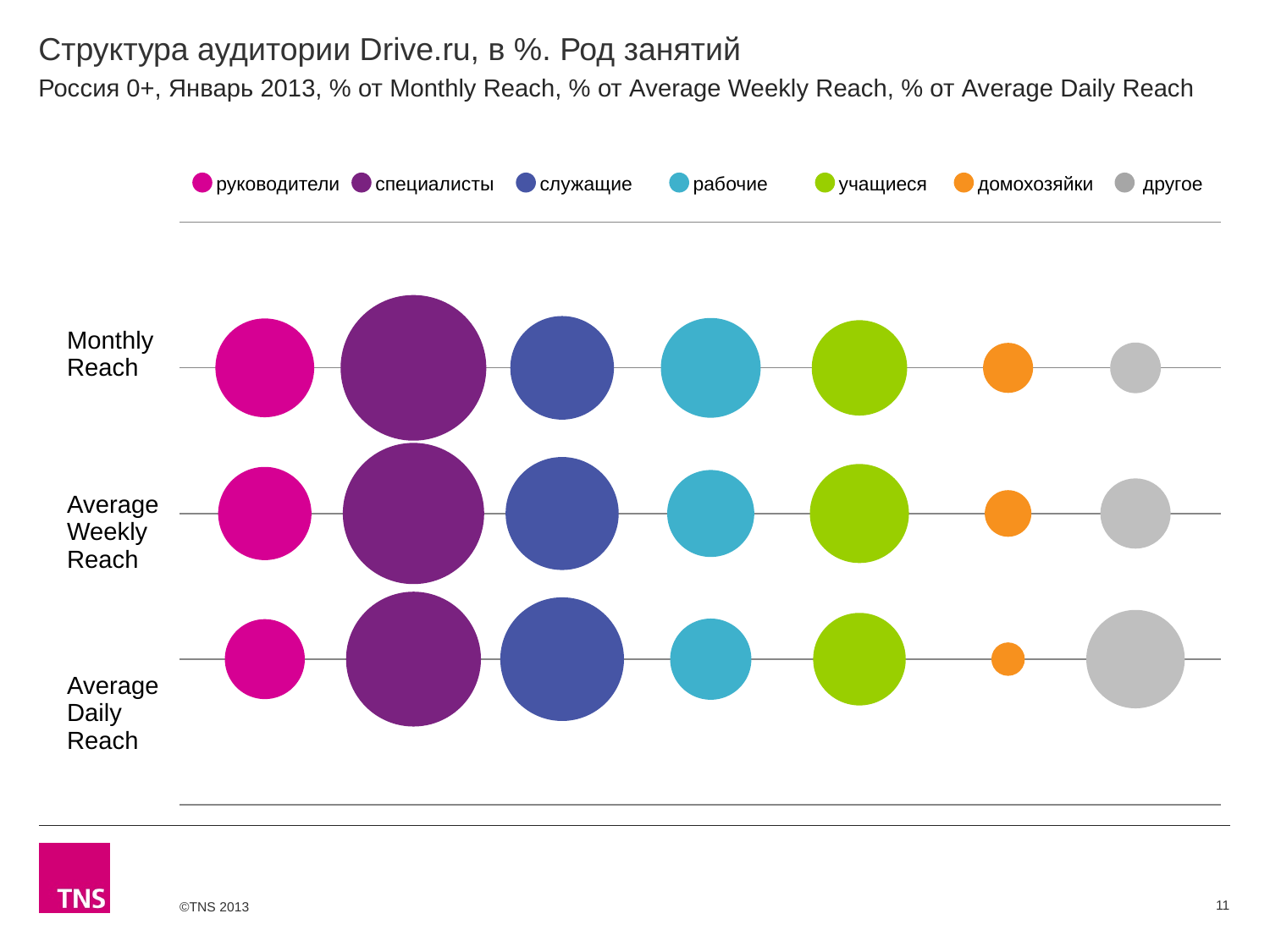
Does the bubble for другое get larger or smaller going from Monthly Reach to Average Daily Reach? larger Which occupation group has the smallest bubble in the Average Weekly Reach row? домохозяйки Which occupation group has the largest bubble in the Average Daily Reach row? специалисты In the Monthly Reach row, which bubble is larger: руководители or домохозяйки? руководители In the Average Daily Reach row, which bubble is larger: другое or домохозяйки? другое Which occupation group has the largest bubble in the Monthly Reach row? специалисты How many series does the legend list? 7 How many reach categories (rows) are plotted in the chart? 3 Which occupation group has the smallest bubble in the Average Daily Reach row? домохозяйки Which legend entry is shown in orange? домохозяйки What is the title of the chart on the slide? Структура аудитории Drive.ru, в %. Род занятий What kind of chart is shown on the slide? bubble chart